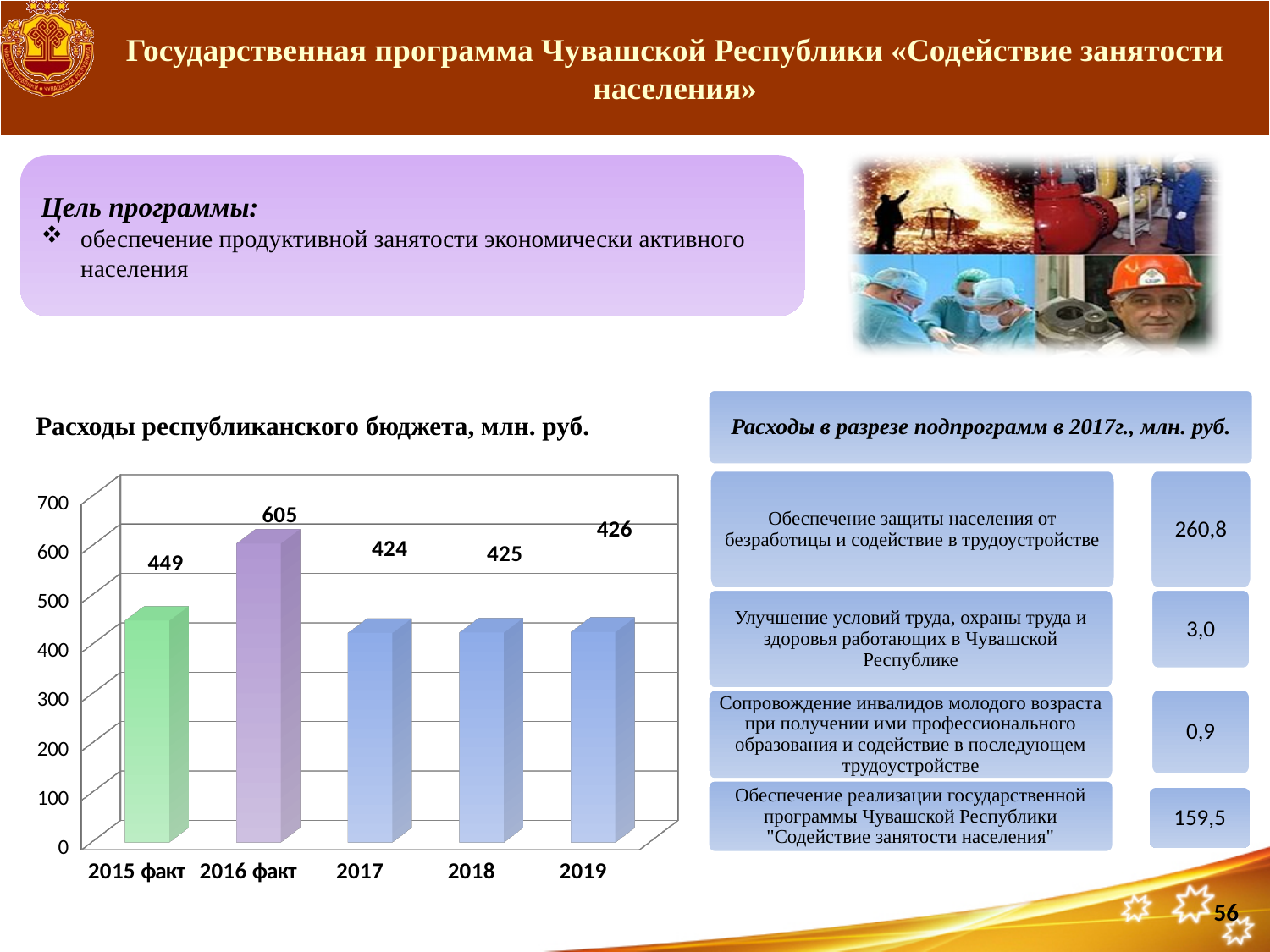
Is the value for 2016 факт greater or less than 500 in the chart 'Расходы республиканского бюджета, млн. руб.'? greater What is the difference between the values for 2016 факт and 2019 in the chart 'Расходы республиканского бюджета, млн. руб.'? 179 What is the difference between the values for 2016 факт and 2015 факт in the chart 'Расходы республиканского бюджета, млн. руб.'? 156 Which category has the lowest value in the chart 'Расходы республиканского бюджета, млн. руб.'? 2017 In the chart 'Расходы республиканского бюджета, млн. руб.', which is larger: the value for 2015 факт or the value for 2018? 2015 факт What is the value for 2015 факт in the chart 'Расходы республиканского бюджета, млн. руб.'? 449 How many categories are shown on the x axis of the chart 'Расходы республиканского бюджета, млн. руб.'? 5 In the chart 'Расходы республиканского бюджета, млн. руб.', do the values rise or fall from 2016 факт to 2017? fall What is the value for 2019 in the chart 'Расходы республиканского бюджета, млн. руб.'? 426 What is the value for 2016 факт in the chart 'Расходы республиканского бюджета, млн. руб.'? 605 What kind of chart is 'Расходы республиканского бюджета, млн. руб.'? bar chart Which category has the highest value in the chart 'Расходы республиканского бюджета, млн. руб.'? 2016 факт